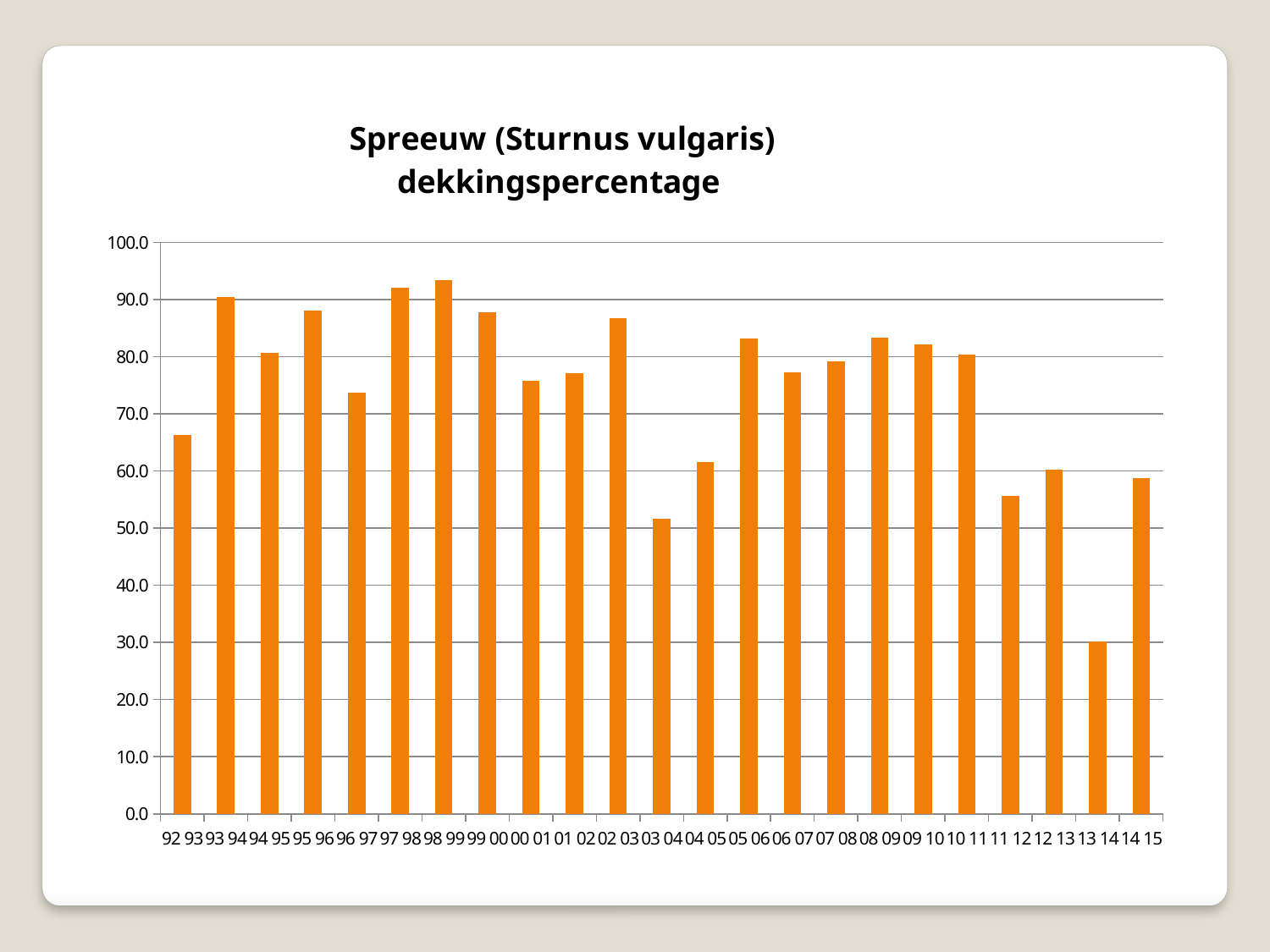
Is the value for 11 12 greater or less than 60.0? less Is the value for 98 99 greater or less than 90.0? greater Which season has the highest dekkingspercentage? 98 99 Is the value for 13 14 greater or less than 40.0? less What kind of chart is shown on the slide? bar chart Which is larger, the value for 13 14 or the value for 14 15? 14 15 What is the title of the chart? Spreeuw (Sturnus vulgaris) dekkingspercentage Do the values generally rise or fall from 08 09 to 13 14? fall Which season has the lowest dekkingspercentage? 13 14 Which is larger, the value for 92 93 or the value for 93 94? 93 94 How many bars (seasons) are plotted in the chart? 23